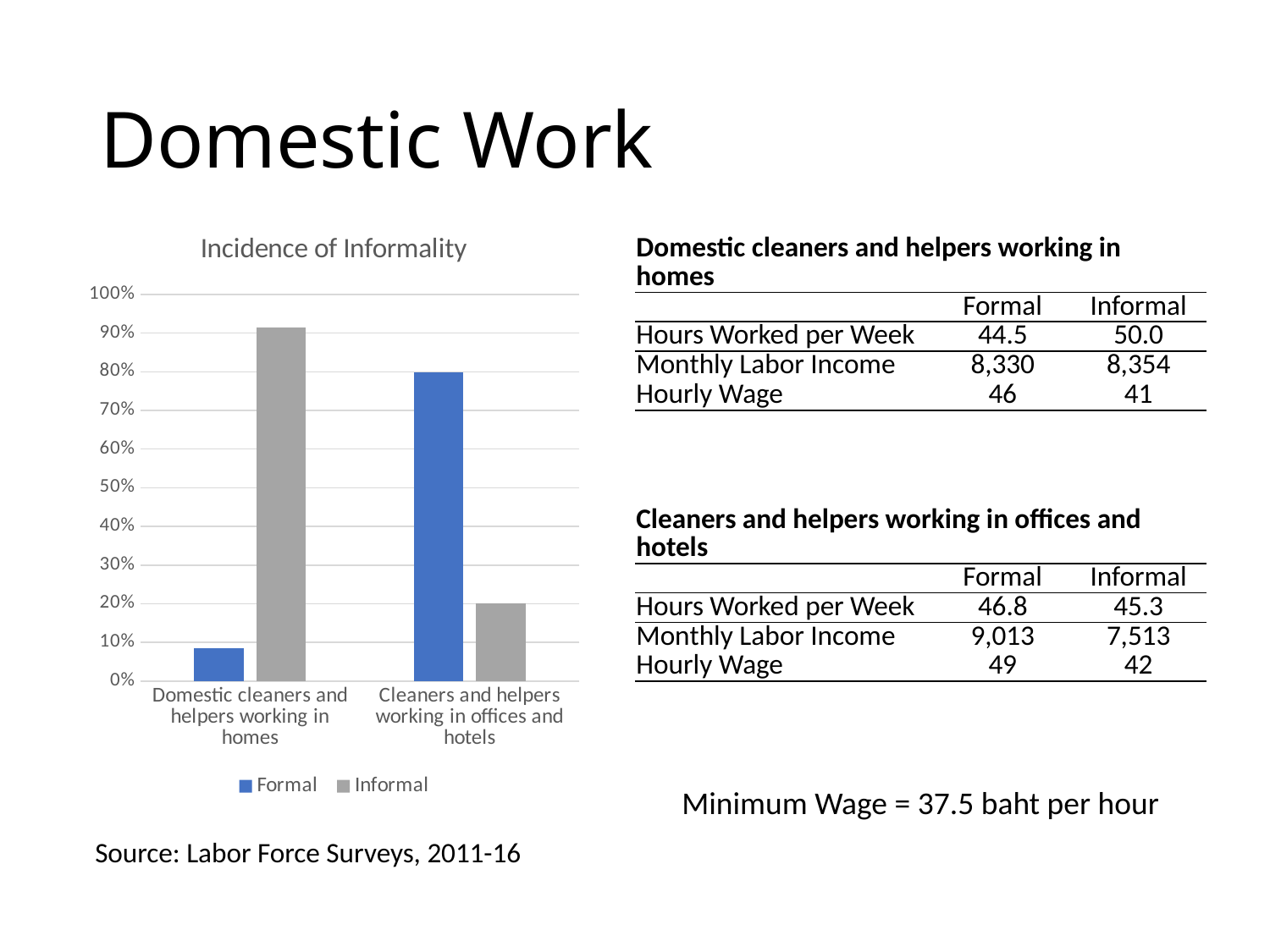
Is the Informal value for Domestic cleaners and helpers working in homes greater or less than 80%? greater Which series is shown in blue in the chart? Formal How many series does the chart legend list? 2 For Domestic cleaners and helpers working in homes, which is larger, the Formal or the Informal value? Informal Is the Formal value for Cleaners and helpers working in offices and hotels greater or less than 70%? greater What type of chart is shown on the slide? bar chart What is the title of the chart? Incidence of Informality Is the Informal value for Cleaners and helpers working in offices and hotels greater or less than 30%? less For Cleaners and helpers working in offices and hotels, which is larger, the Formal or the Informal value? Formal Which category has the higher Informal value in the chart? Domestic cleaners and helpers working in homes How many categories are shown on the x axis of the chart? 2